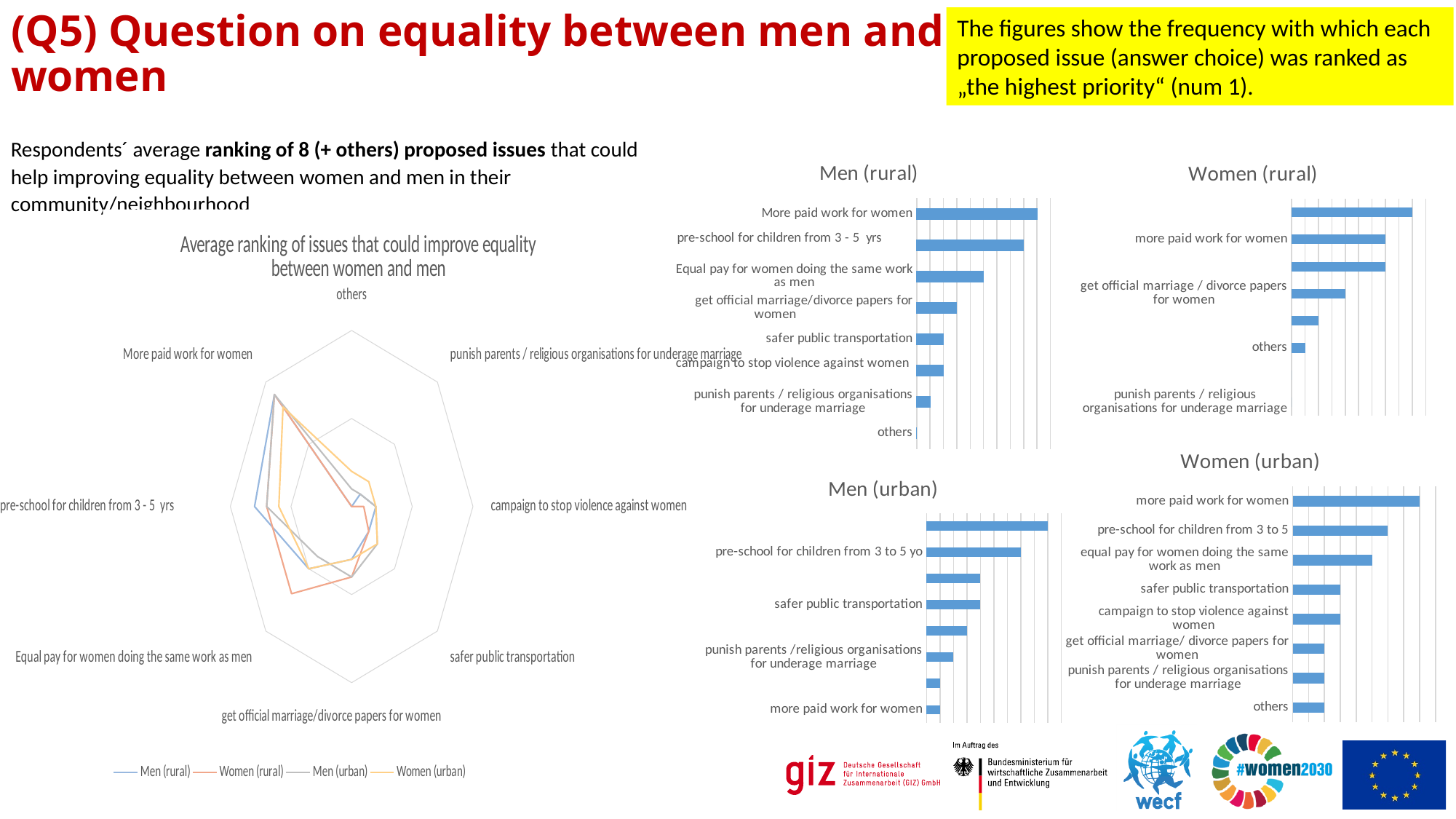
In the 'Women (urban)' chart, which issue has the highest value? more paid work for women What kind of chart is the 'Average ranking of issues that could improve equality between women and men' chart on the left of the slide? Radar chart In the 'Men (rural)' chart, which issue has the lowest value? others How many categories are shown in the 'Men (rural)' chart? 8 In the 'Men (rural)' chart, which issue has the highest value? More paid work for women How many bar charts are shown on the right side of the slide? 4 In the 'Men (rural)' chart, which is larger: 'Equal pay for women doing the same work as men' or 'get official marriage/divorce papers for women'? Equal pay for women doing the same work as men How many series does the legend of the radar chart on the left list? 4 What kind of chart is the 'Men (rural)' chart? Bar chart In the 'Women (urban)' chart, which is larger: 'pre-school for children from 3 to 5' or 'safer public transportation'? pre-school for children from 3 to 5 Which series are listed in the legend of the radar chart on the left? Men (rural), Women (rural), Men (urban), Women (urban) How many issue categories are plotted on the radar chart on the left? 8